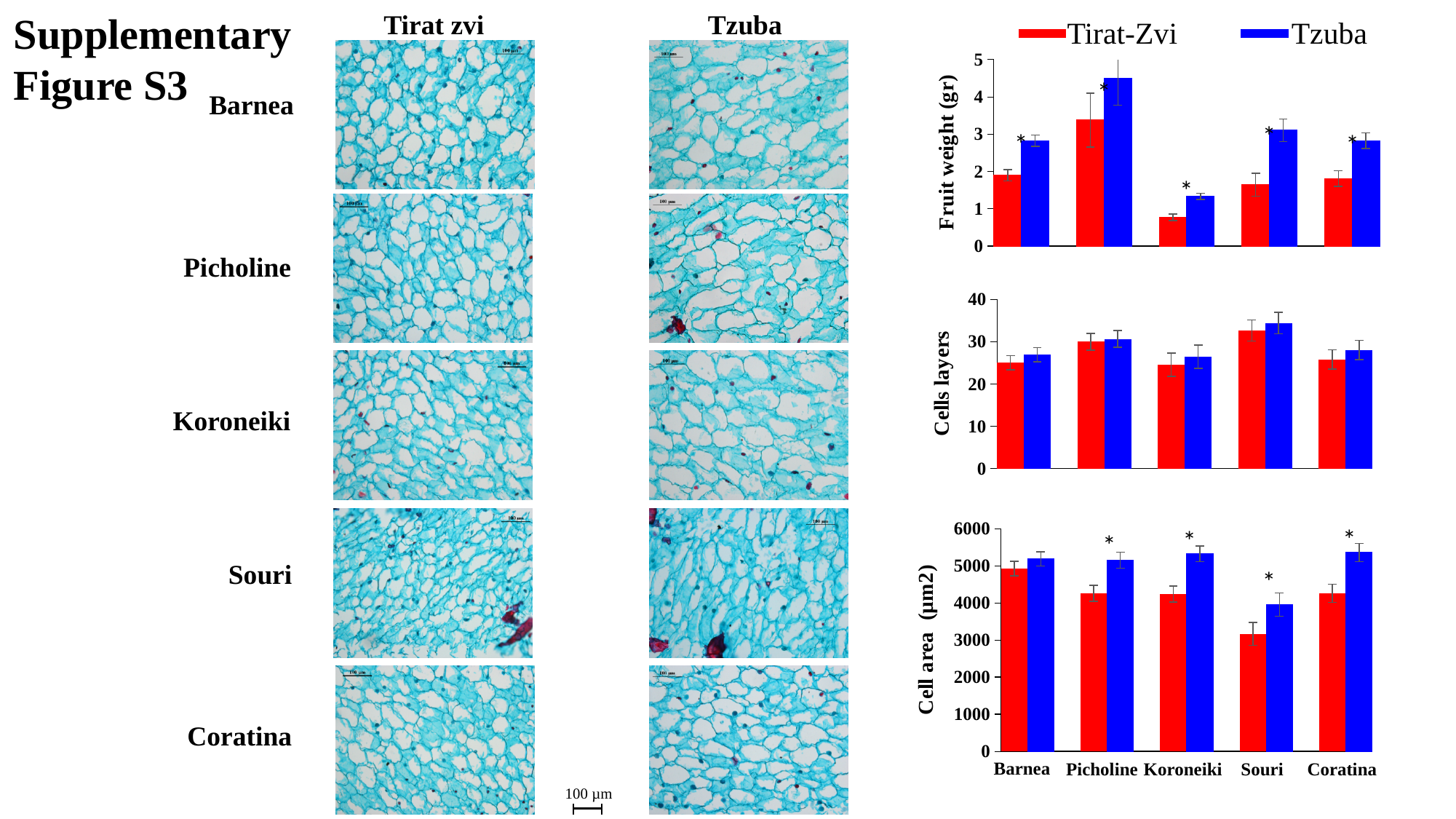
In the Cell area (µm2) chart, how many cultivars are shown on the x axis? 5 In the Fruit weight (gr) chart, how many series does the legend list? 2 In the Cell area (µm2) chart, which cultivar has the lowest Tzuba value? Souri In the Fruit weight (gr) chart, which cultivar has the lowest Tirat-Zvi value? Koroneiki In the Fruit weight (gr) chart, what kind of chart is used? bar chart In the Fruit weight (gr) chart, which cultivar has the highest Tzuba value? Picholine In the Fruit weight (gr) chart, is the Tzuba value for Picholine greater or less than 4? greater In the Cells layers chart, which cultivar has the highest Tirat-Zvi value? Souri In the Cell area (µm2) chart, is the Tirat-Zvi value for Souri greater or less than 4000? less In the Fruit weight (gr) chart, for Souri, which series has the larger value, Tirat-Zvi or Tzuba? Tzuba In the Cells layers chart, is the Tzuba value for Souri greater or less than 30? greater